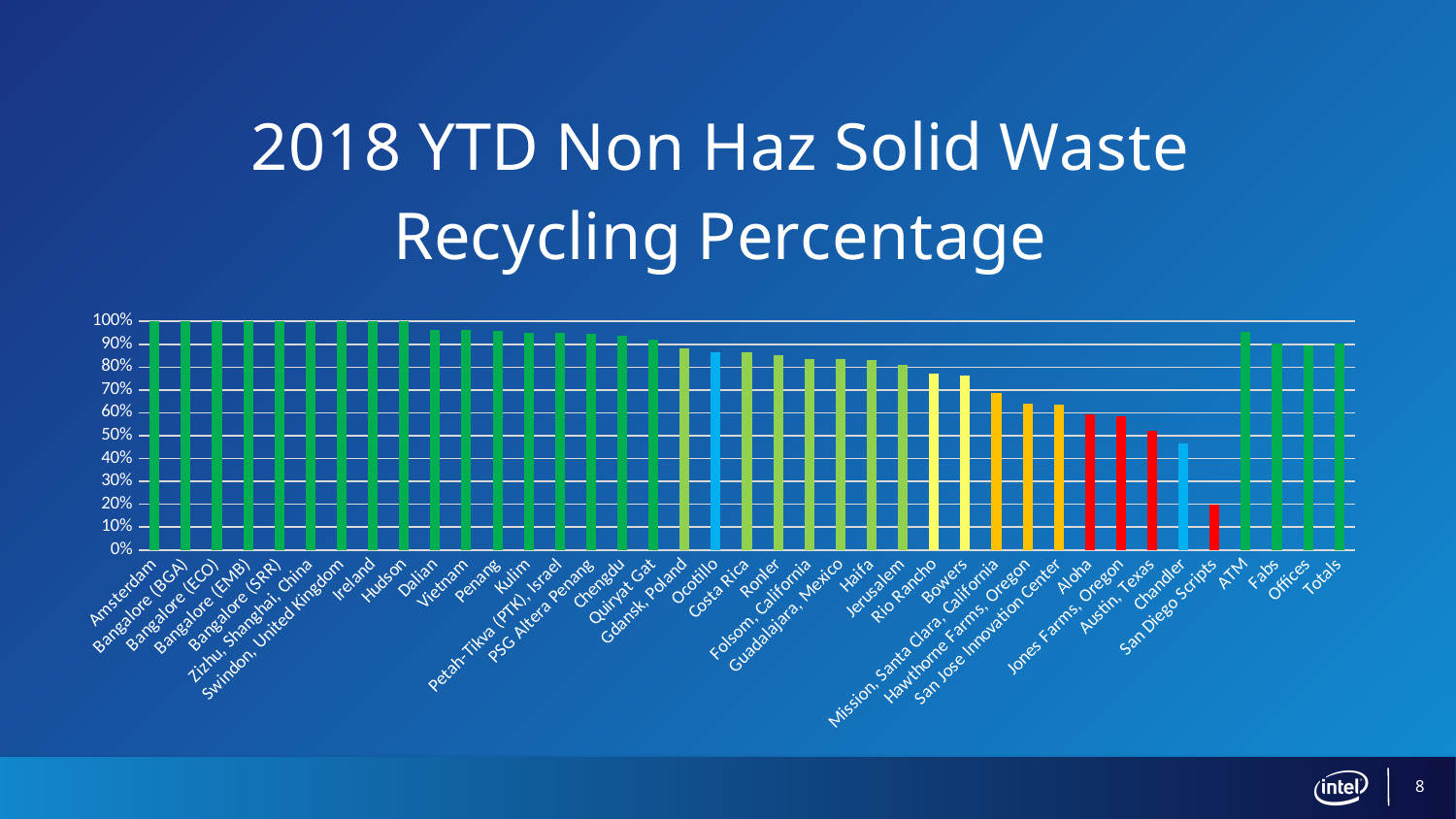
Which has a higher recycling percentage, Chandler or Aloha? Aloha Which category has the lowest recycling percentage? San Diego Scripts Is the value for Totals greater or less than 80%? greater Moving from Amsterdam on the left to San Diego Scripts on the right, do the values generally rise or fall? fall Is the value for Aloha greater or less than 50%? greater What is the title of the chart? 2018 YTD Non Haz Solid Waste Recycling Percentage Is the value for Amsterdam greater or less than 90%? greater What kind of chart is shown on the slide? bar chart Which has a higher recycling percentage, San Diego Scripts or Chandler? Chandler